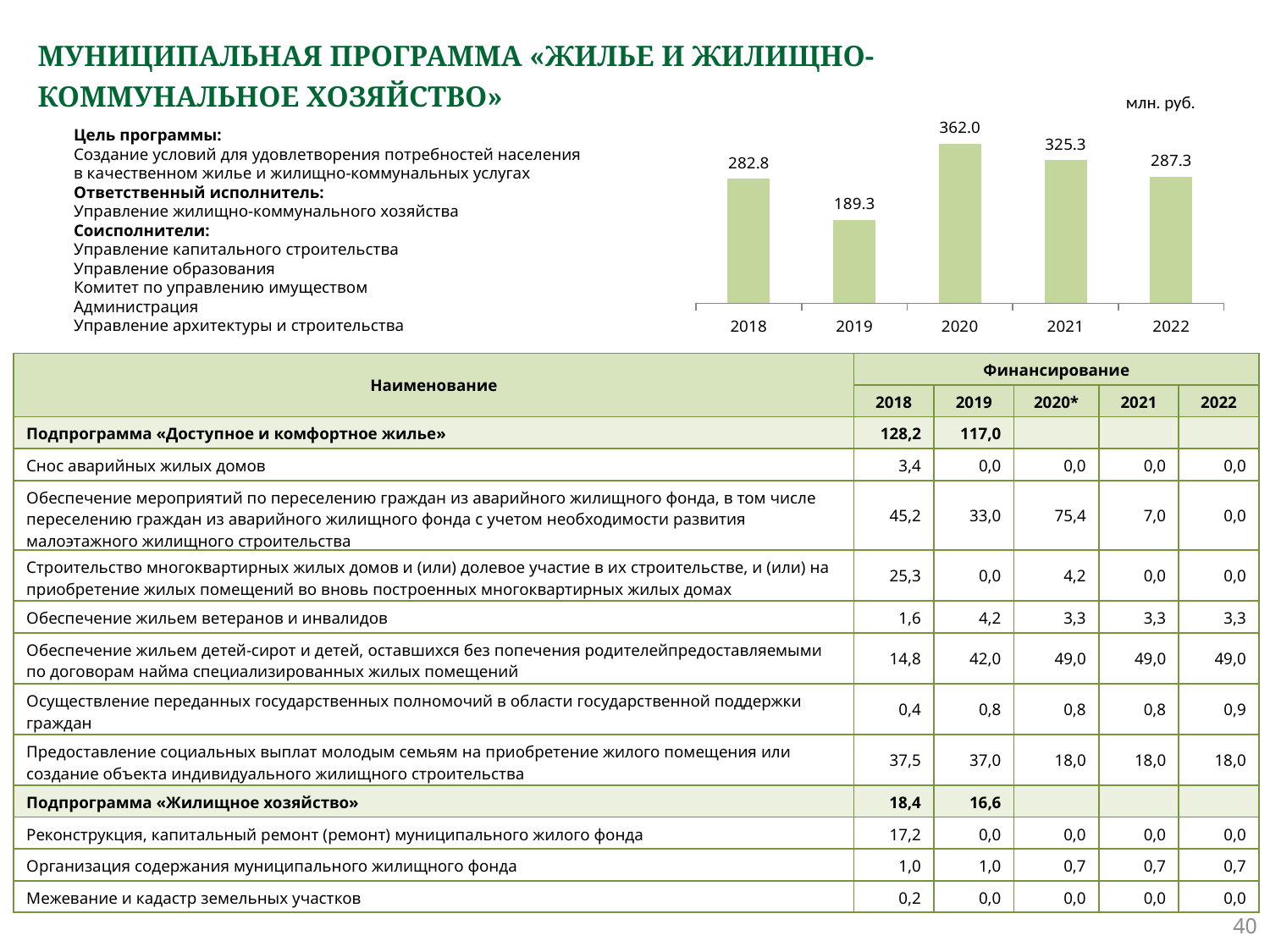
What is the value shown for 2020 on the bar chart? 362.0 What unit of measurement is indicated for the bar chart? млн. руб. What is the value shown for 2019 on the bar chart? 189.3 Which year has the lowest value on the bar chart? 2019 Which year has the highest value on the bar chart? 2020 Which is larger on the bar chart, the value for 2021 or the value for 2019? 2021 Which is larger on the bar chart, the value for 2018 or the value for 2022? 2022 What is the difference between the values for 2018 and 2019 on the bar chart? 93.5 How many years are shown on the bar chart? 5 What is the difference between the values for 2020 and 2021 on the bar chart? 36.7 What kind of chart is shown on the slide? bar chart What is the value shown for 2022 on the bar chart? 287.3